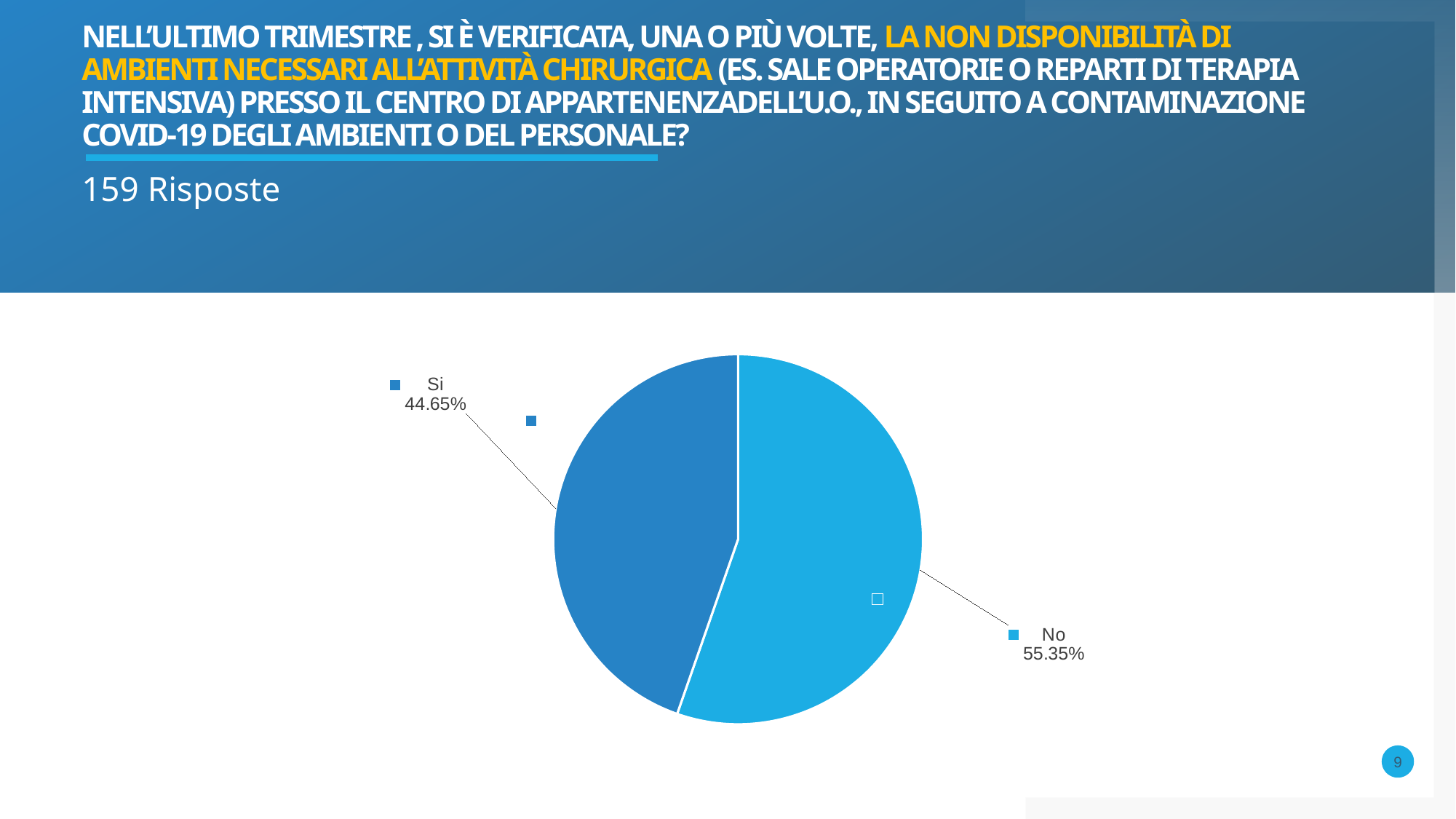
Which slice of the pie is the largest? No What kind of chart is shown on the slide? pie chart Which is larger, the share for "Si" or the share for "No"? No How many slices does the pie chart have? 2 What colour is the "No" slice of the pie? light blue Is the share for "No" greater or less than 50%? greater What percentage of responses is labelled "Si"? 44.65% Is the share for "Si" greater or less than 50%? less How many responses does the slide say the chart is based on? 159 Which slice of the pie is the smallest? Si What percentage of responses is labelled "No"? 55.35% What is the difference in percentage points between the "No" slice and the "Si" slice? 10.7